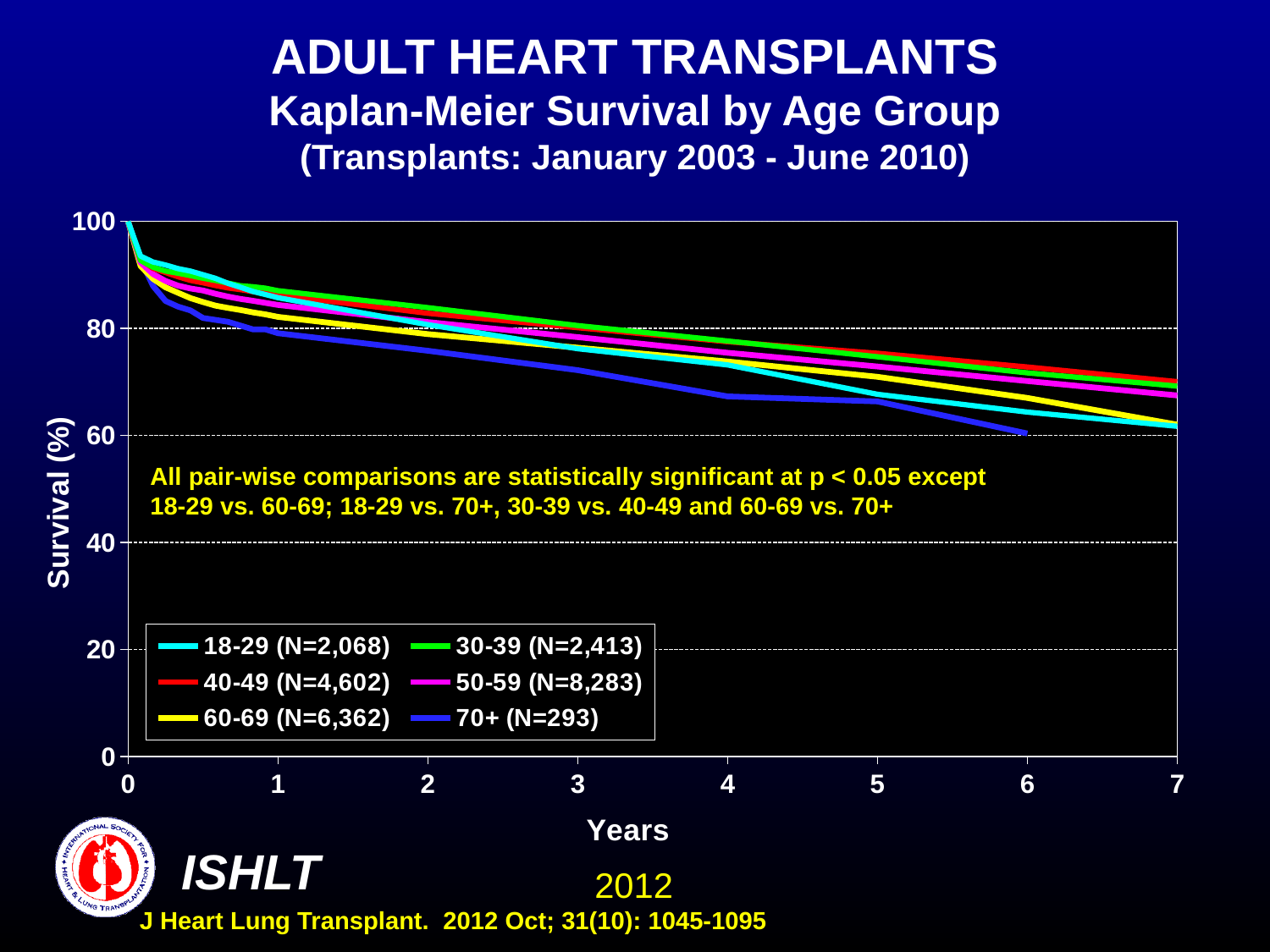
What kind of chart is shown on the slide? line chart According to the legend, what is the N for the 50-59 age group? 8,283 Is the survival for the 70+ group at year 4 greater or less than 80? less Do the survival curves rise or fall as years increase? fall At year 3, which group has higher survival: 60-69 or 70+? 60-69 Is the survival for the 40-49 group at year 7 greater or less than 60? greater What is the survival (%) for all age groups at year 0? 100 Which age group has the lowest survival at year 3? 70+ Is the survival for the 70+ group at year 4 greater or less than 60? greater How many age groups does the legend list? 6 At year 6, which group has higher survival: 18-29 or 40-49? 40-49